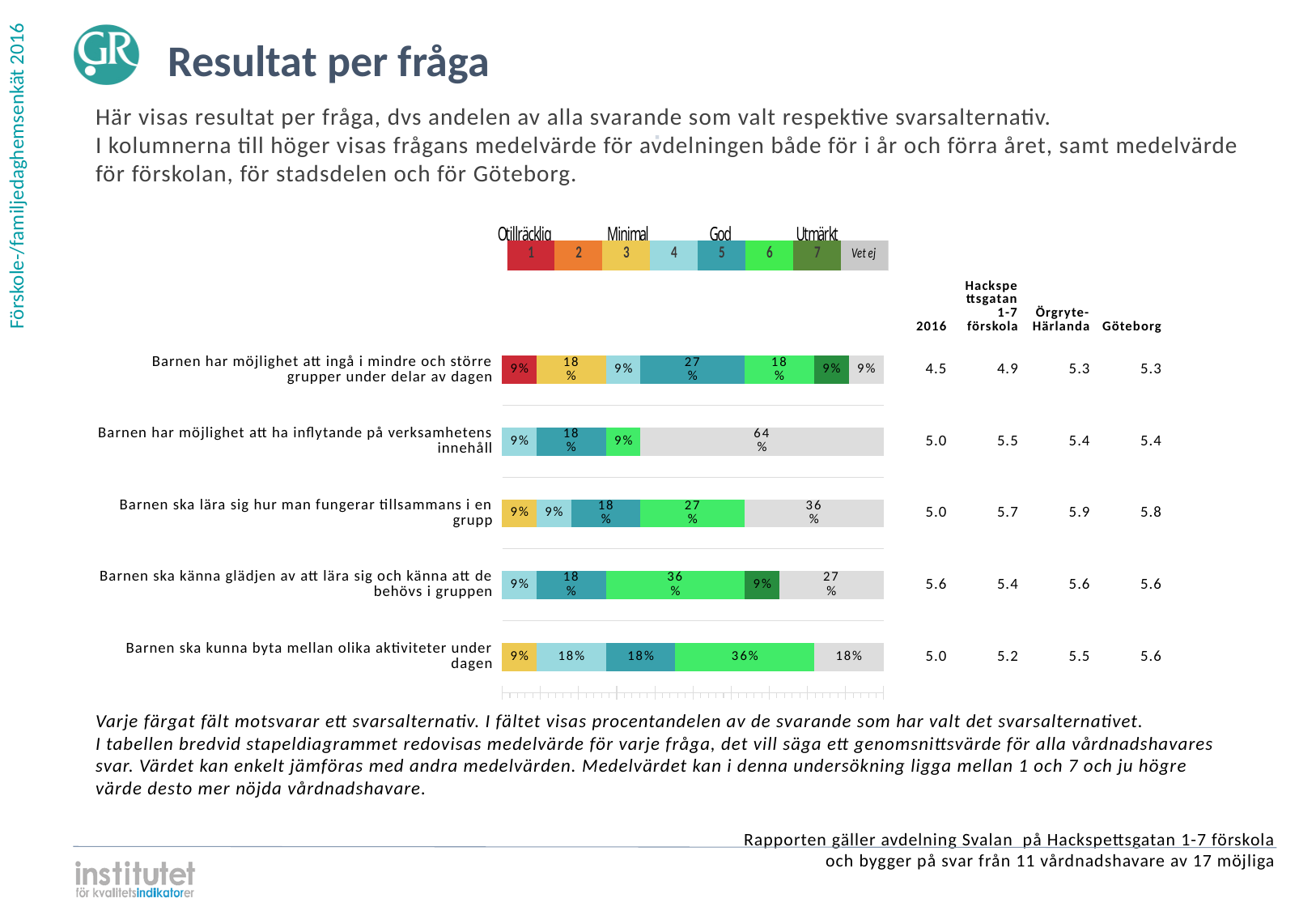
How many answer alternatives does the legend above the chart list? 8 Which question has the largest 'Vet ej' share? Barnen har möjlighet att ha inflytande på verksamhetens innehåll How many questions (bars) are shown in the chart? 5 For 'Barnen ska kunna byta mellan olika aktiviteter under dagen', what is the difference between the share choosing alternative 6 (36%) and the share choosing 'Vet ej' (18%)? 18% Which is larger for 'Barnen ska lära sig hur man fungerar tillsammans i en grupp': the Hackspettsgatan 1-7 förskola mean or the Örgryte-Härlanda mean? Örgryte-Härlanda What percentage of respondents chose 'Vet ej' for 'Barnen har möjlighet att ha inflytande på verksamhetens innehåll'? 64% What is the 2016 mean value for 'Barnen ska känna glädjen av att lära sig och känna att de behövs i gruppen'? 5.6 What percentage chose answer alternative 5 (God) for 'Barnen har möjlighet att ingå i mindre och större grupper under delar av dagen'? 27% What percentage chose answer alternative 6 for 'Barnen ska kunna byta mellan olika aktiviteter under dagen'? 36% What is the Göteborg mean value for 'Barnen ska lära sig hur man fungerar tillsammans i en grupp'? 5.8 Which question has the lowest 2016 mean value? Barnen har möjlighet att ingå i mindre och större grupper under delar av dagen What kind of chart is used to show the results per question? Stacked bar chart